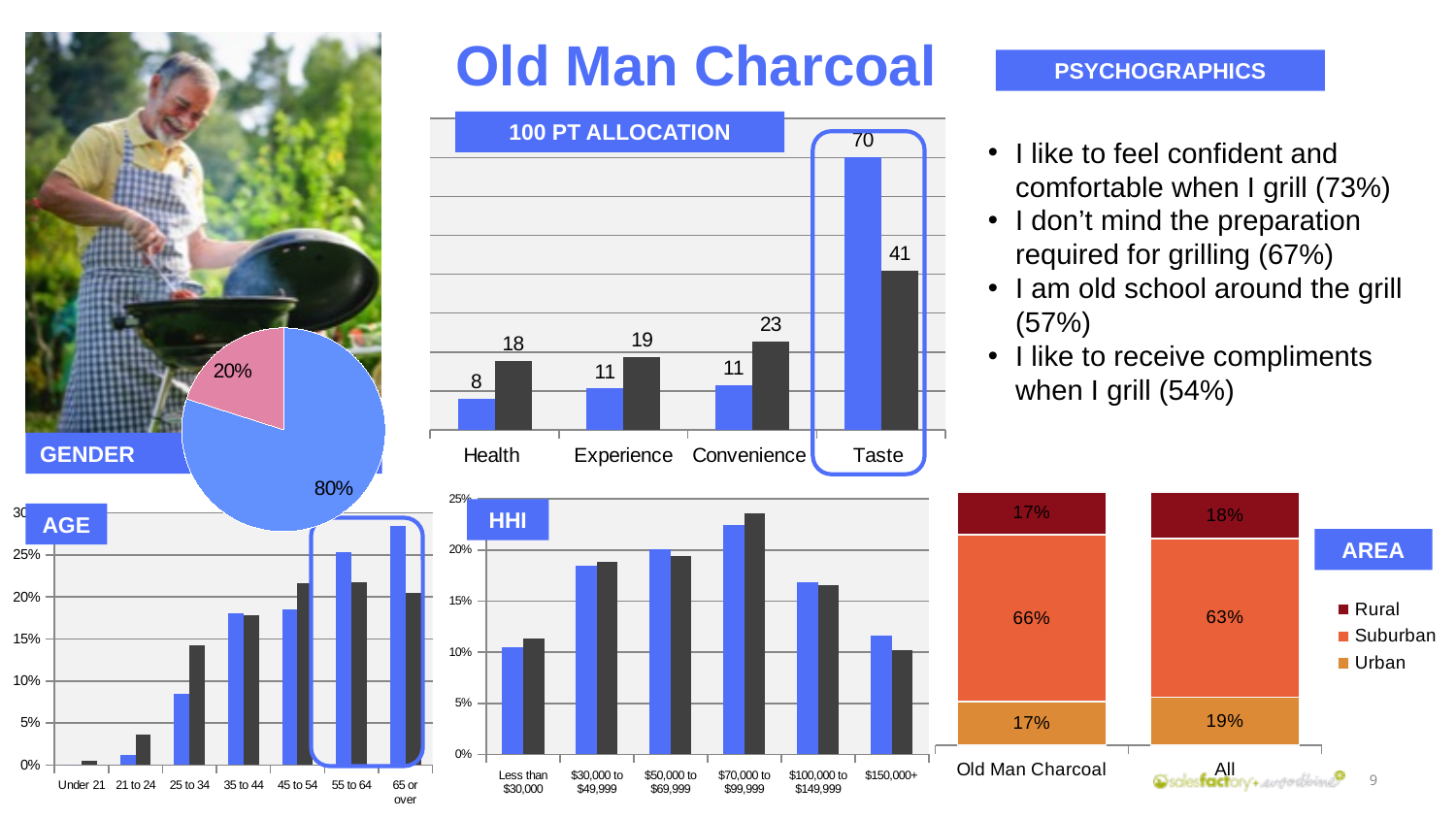
In the AREA chart, what is the Suburban share for Old Man Charcoal? 66% How many categories are shown in the 100 PT ALLOCATION chart? 4 In the AREA chart, which bar has the larger Urban share, Old Man Charcoal or All? All How many age categories are shown in the AGE chart? 7 What kind of chart is the GENDER chart? Pie chart In the 100 PT ALLOCATION chart, what is the difference between the blue and dark bars for Taste? 29 In the HHI chart, is the blue bar for $70,000 to $99,999 greater or less than 20%? greater In the 100 PT ALLOCATION chart, what is the value of the blue bar for Taste? 70 In the 100 PT ALLOCATION chart, which category has the highest values? Taste In the 100 PT ALLOCATION chart, what is the value of the dark bar for Convenience? 23 In the GENDER pie chart, what is the share of the larger slice? 80% How many series does the legend of the AREA chart list? 3